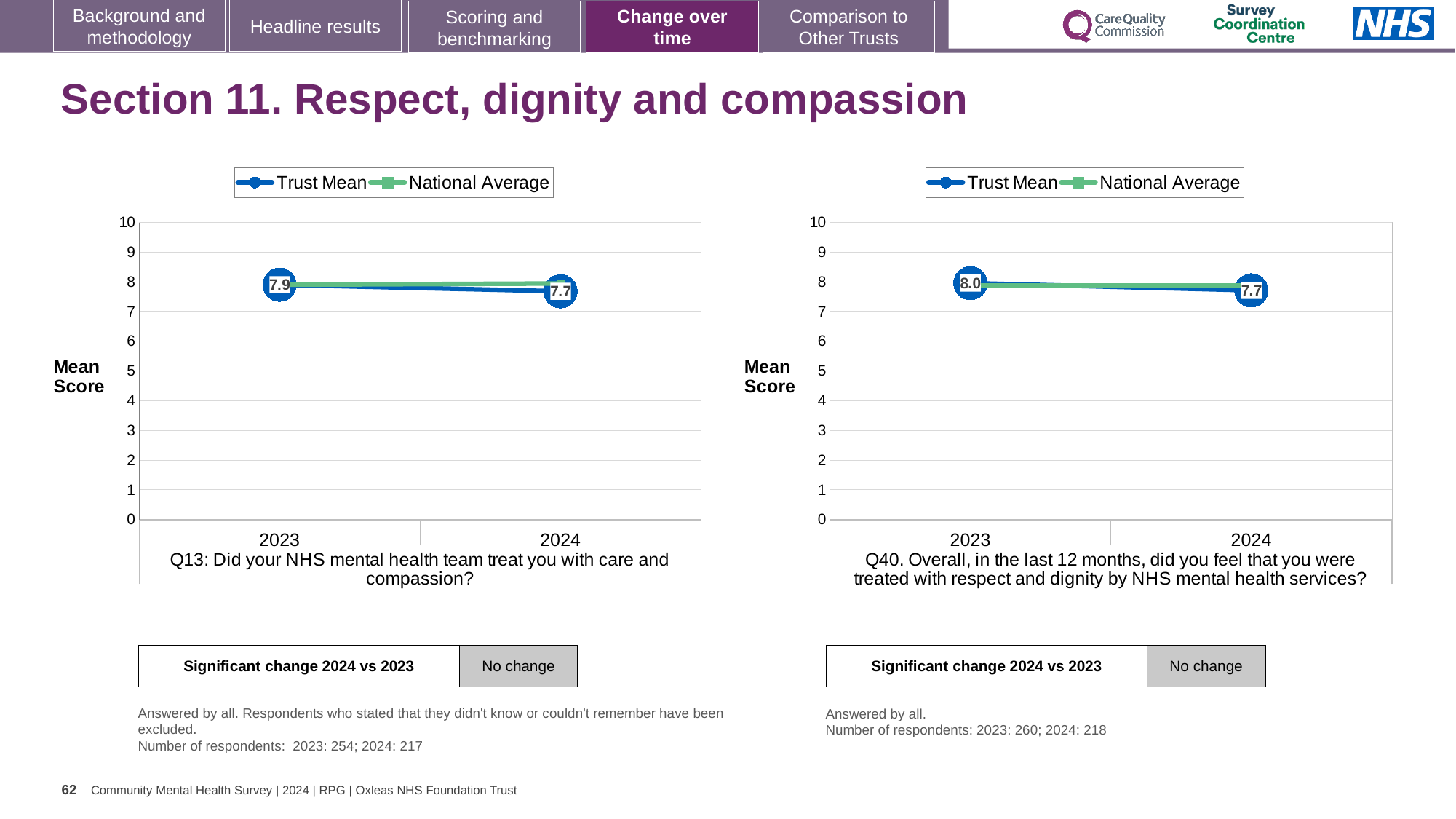
How many series does the legend of the left chart (Q13) list? 2 In the left chart (Q13), what is the Trust Mean score for 2024? 7.7 How many years are plotted on the x axis of the right chart (Q40)? 2 What is the y-axis label on the right chart (Q40)? Mean Score In the right chart (Q40), which year has the higher Trust Mean, 2023 or 2024? 2023 In the left chart (Q13), is the National Average value for 2024 greater or less than 5? greater In the right chart (Q40), what is the Trust Mean score for 2023? 8.0 What kind of chart is the left chart (Q13)? line chart In the right chart (Q40), by how much did the Trust Mean change from 2023 to 2024? 0.3 In the left chart (Q13), does the Trust Mean rise or fall from 2023 to 2024? fall In the right chart (Q40), what is the Trust Mean score for 2024? 7.7 In the left chart (Q13), what is the Trust Mean score for 2023? 7.9